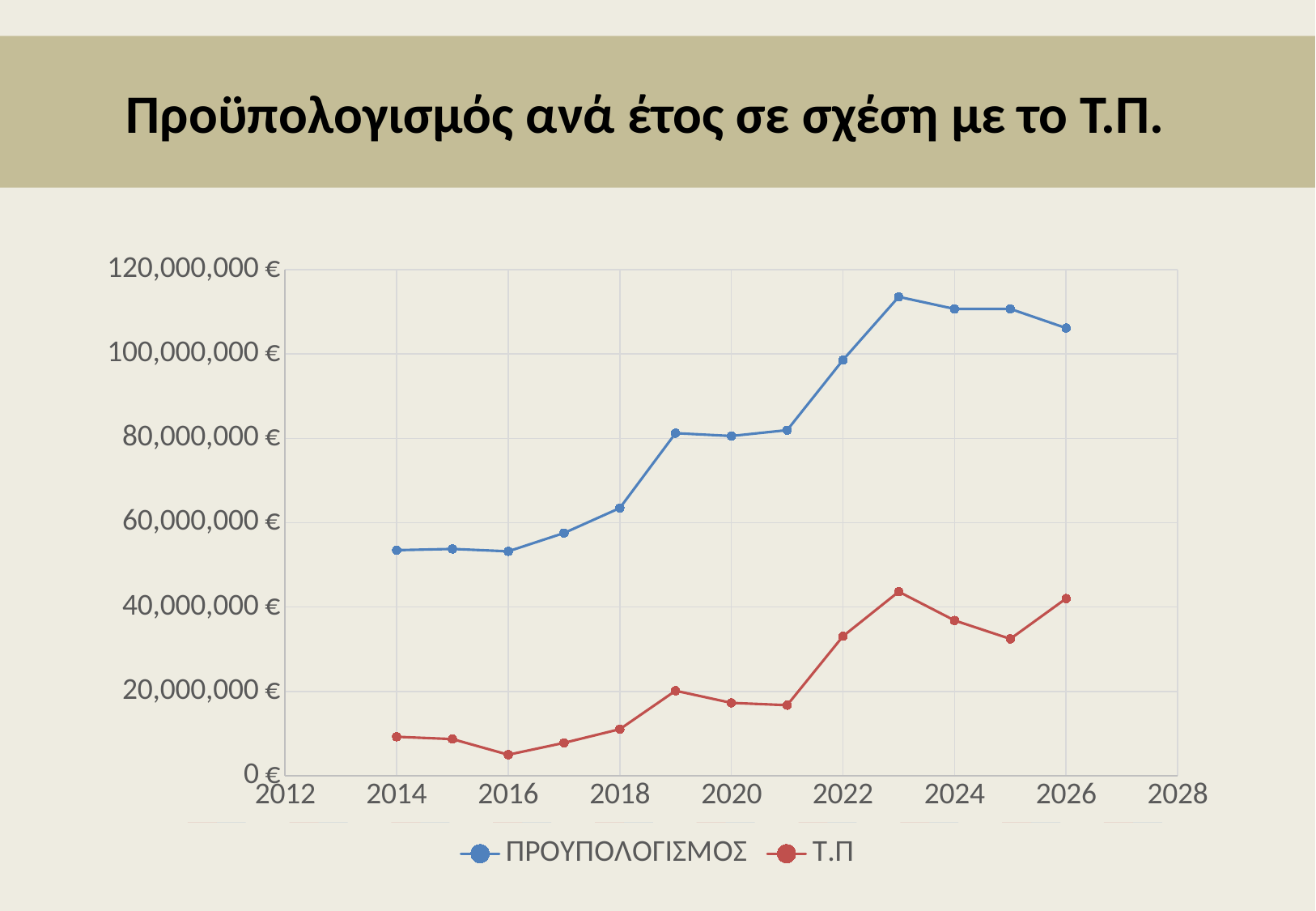
How many data points does the ΠΡΟΥΠΟΛΟΓΙΣΜΟΣ series have? 13 Does the ΠΡΟΥΠΟΛΟΓΙΣΜΟΣ series rise or fall from 2014 to 2023? rise Is the ΠΡΟΥΠΟΛΟΓΙΣΜΟΣ value for 2014 greater or less than 60,000,000 €? less What kind of chart is shown on the slide? line chart How many series does the legend list? 2 Is the ΠΡΟΥΠΟΛΟΓΙΣΜΟΣ value for 2022 greater or less than 80,000,000 €? greater Is the Τ.Π value for 2022 greater or less than 20,000,000 €? greater In which year does the ΠΡΟΥΠΟΛΟΓΙΣΜΟΣ series reach its highest value? 2023 Which is larger for the ΠΡΟΥΠΟΛΟΓΙΣΜΟΣ series, the value for 2023 or the value for 2026? 2023 Which is larger for the Τ.Π series, the value for 2024 or the value for 2025? 2024 In which year does the Τ.Π series reach its lowest value? 2016